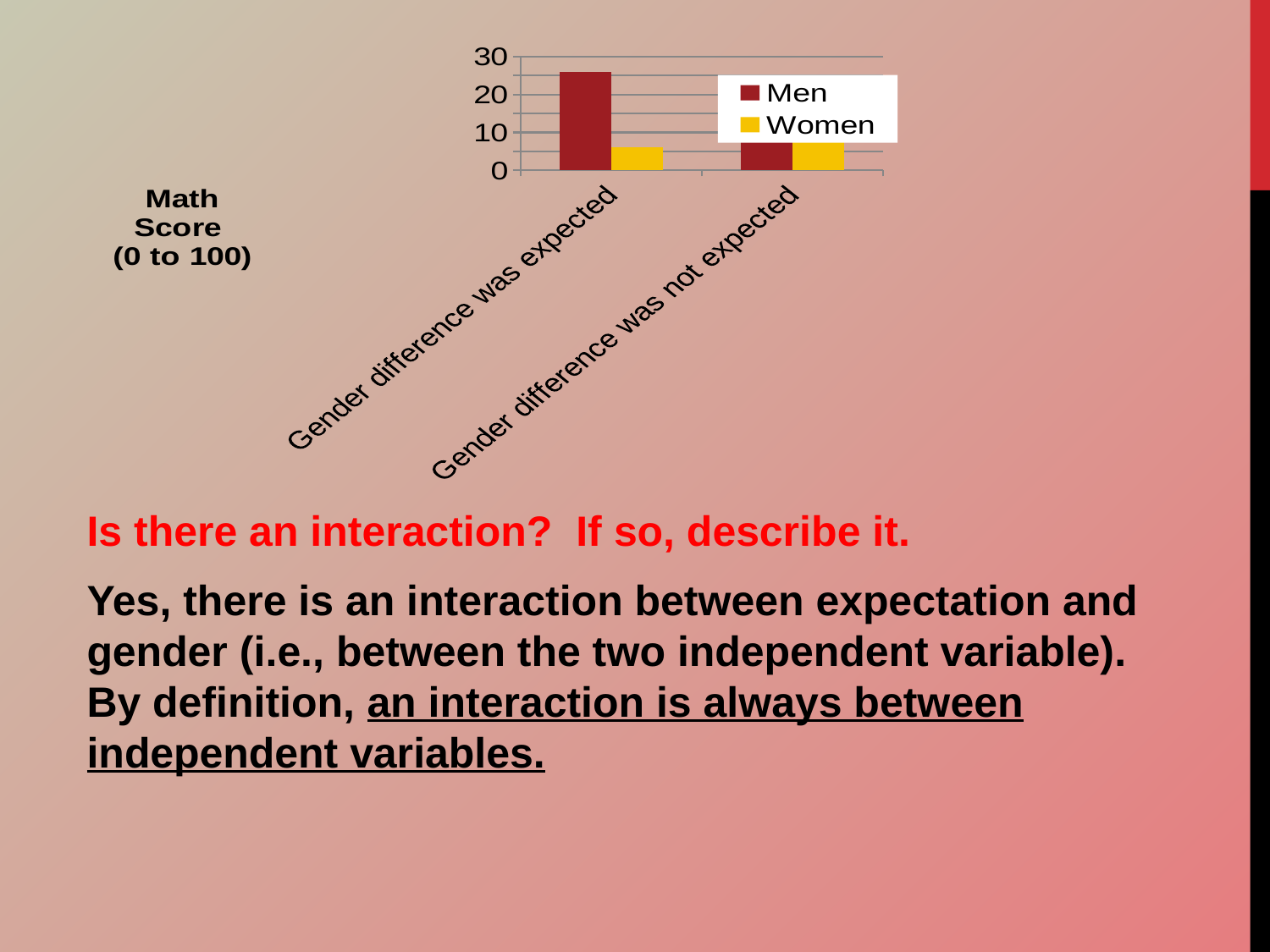
What label is given for the vertical axis of the chart? Math Score (0 to 100) What kind of chart is shown on the slide? bar chart Is the value for Men in the 'Gender difference was expected' category greater or less than 20? greater How many series does the legend list? 2 Is the value for Women in the 'Gender difference was expected' category greater or less than 10? less Which series has the higher value in the 'Gender difference was expected' category, Men or Women? Men Which bar is the highest in the chart? Men, Gender difference was expected What are the two entries in the chart's legend? Men, Women How many categories are shown on the x axis? 2 Is the value for Men in the 'Gender difference was expected' category greater or less than 30? less